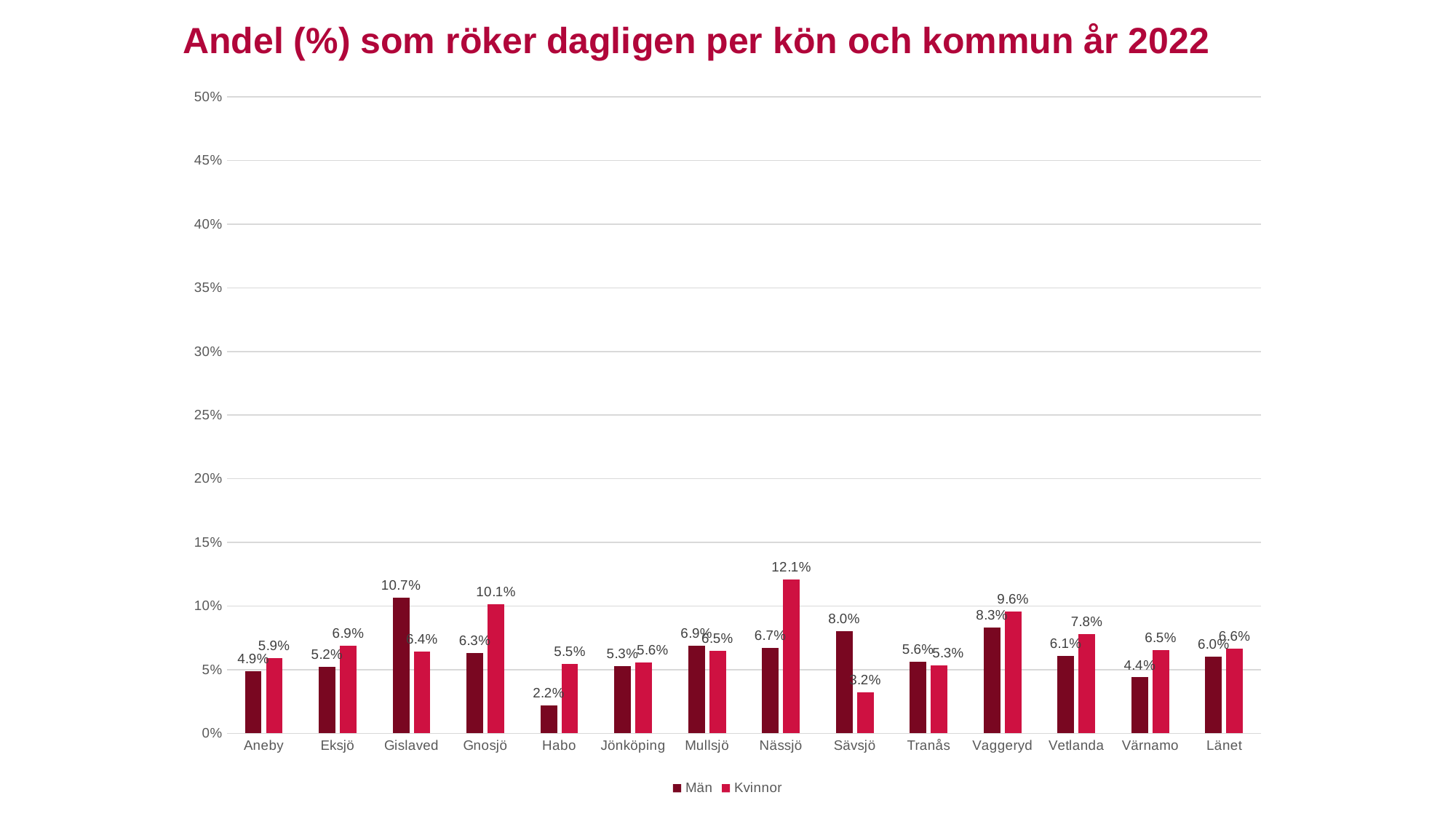
How many series does the legend list? 2 Which municipality has the lowest value for Män? Habo Which municipality has the highest value for Kvinnor? Nässjö What is the value for Kvinnor in Länet? 6.6% In Gnosjö, which series has the larger value, Män or Kvinnor? Kvinnor What kind of chart is shown on the slide? Bar chart What is the difference between the Kvinnor and Män values in Vaggeryd? 1.3 percentage points Which municipality has the highest value for Män? Gislaved What is the value for Män in Gislaved? 10.7% How many categories are shown on the x axis? 14 What is the value for Män in Habo? 2.2% What is the value for Kvinnor in Nässjö? 12.1%